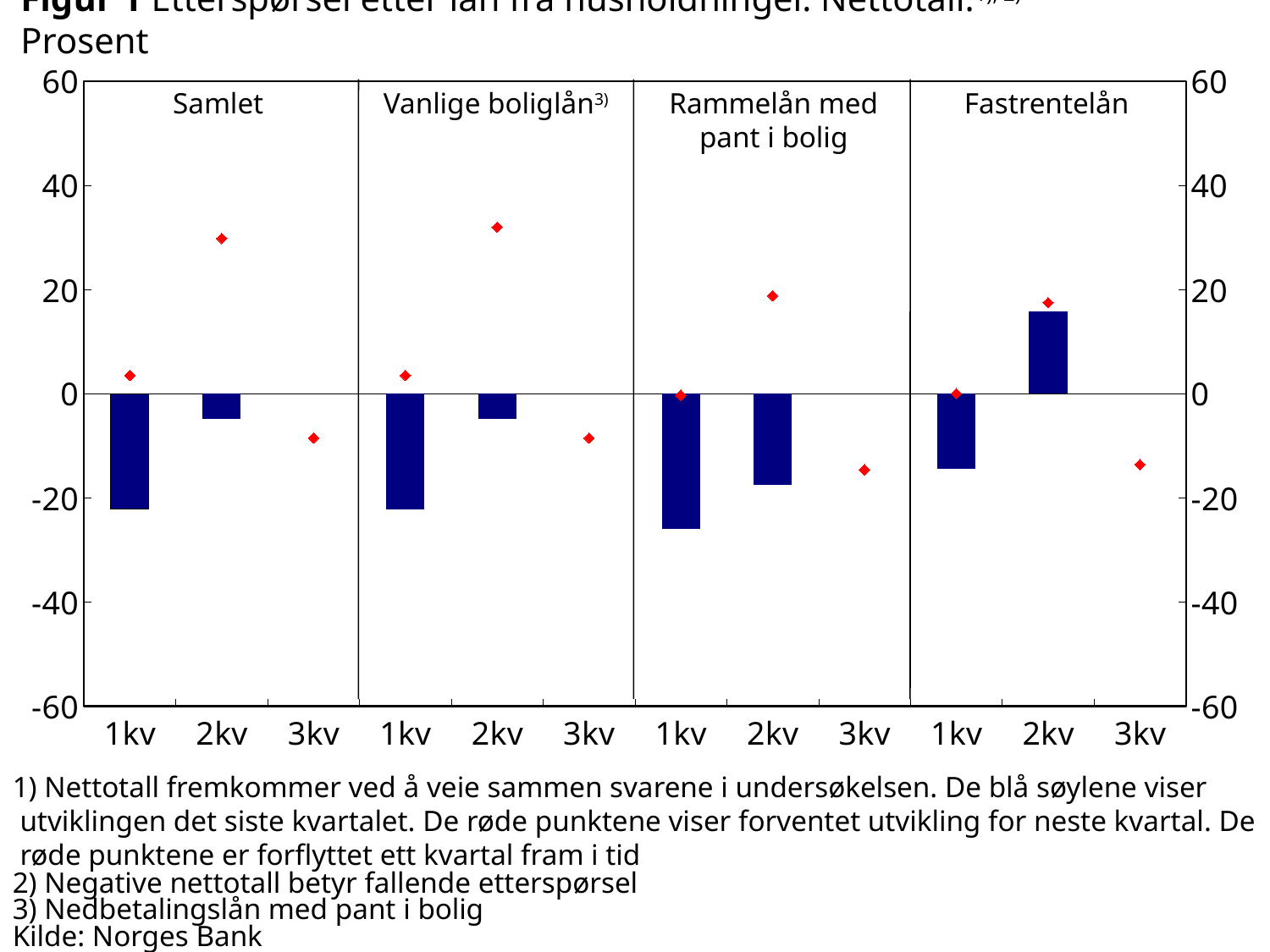
In the Fastrentelån panel, do the bars rise or fall from 1kv to 2kv? rise What colour are the bars in the chart? blue In the Samlet panel, is the bar for 1kv greater or less than -20? less How many panels (loan categories) does the chart have? 4 Which panel has the lowest bar for 1kv? Rammelån med pant i bolig How many quarters are shown on the x axis of each panel? 3 What kind of chart is shown on the slide? bar chart In the Fastrentelån panel, is the bar for 2kv greater or less than 0? greater In the Samlet panel, which bar is lower, 1kv or 2kv? 1kv In the Rammelån med pant i bolig panel, is the bar for 1kv greater or less than -20? less Which panel has the highest bar for 2kv? Fastrentelån